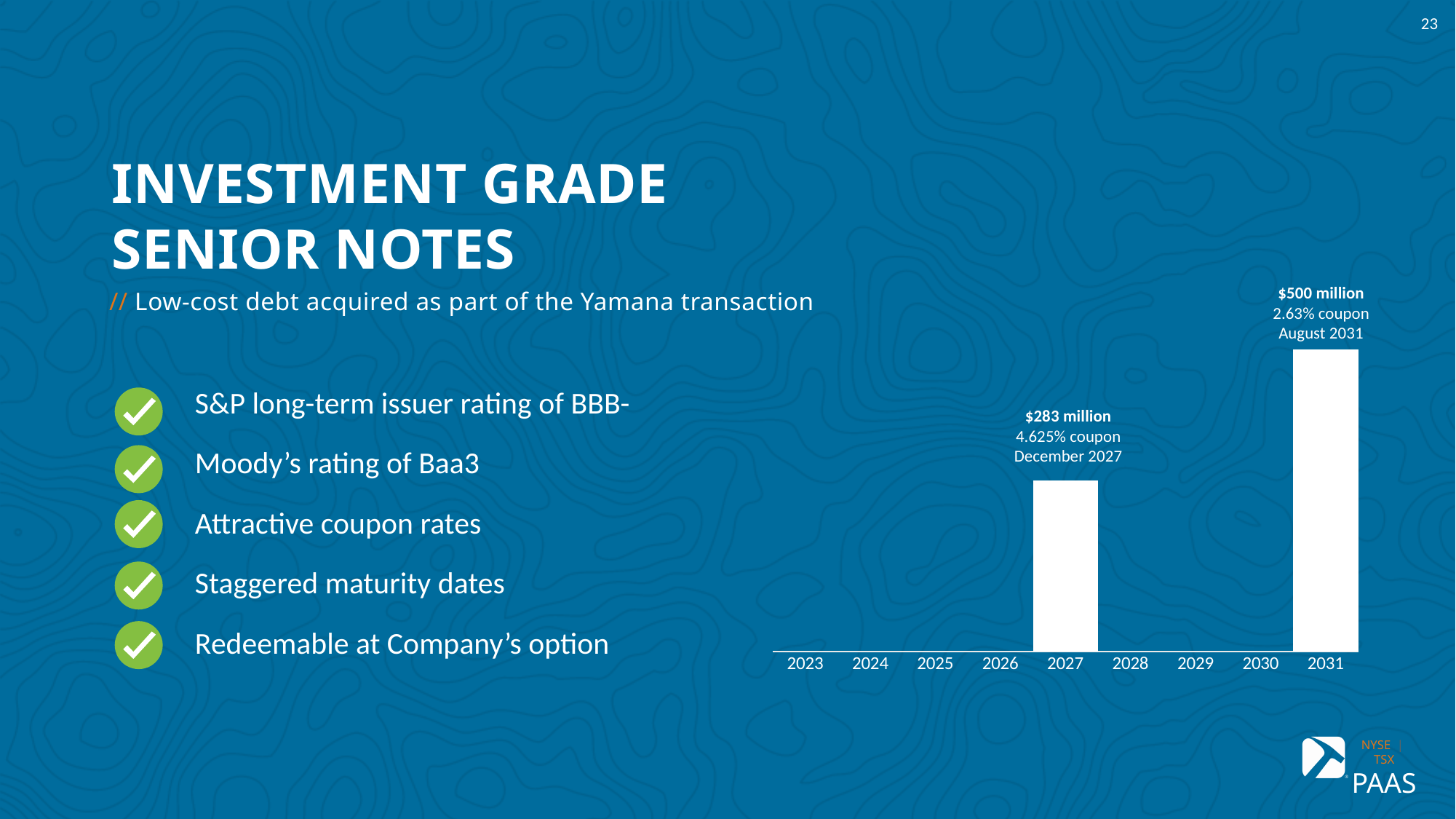
What is the difference between the $500 million and $283 million notes? $217 million What is the value of the senior notes maturing in 2027? $283 million Is the 2031 note larger or smaller than the 2027 note? Larger What is the total of the two senior notes shown on the chart? $783 million What is the coupon rate on the notes maturing in August 2031? 2.63% How many years are labelled on the x axis of the chart? 9 Which maturity year has the smaller bar, 2027 or 2031? 2027 What is the coupon rate on the notes maturing in December 2027? 4.625% What is the value of the senior notes maturing in 2031? $500 million How many bars are plotted on the chart? 2 What kind of chart is shown on the slide? Bar chart Which maturity year has the larger bar, 2027 or 2031? 2031